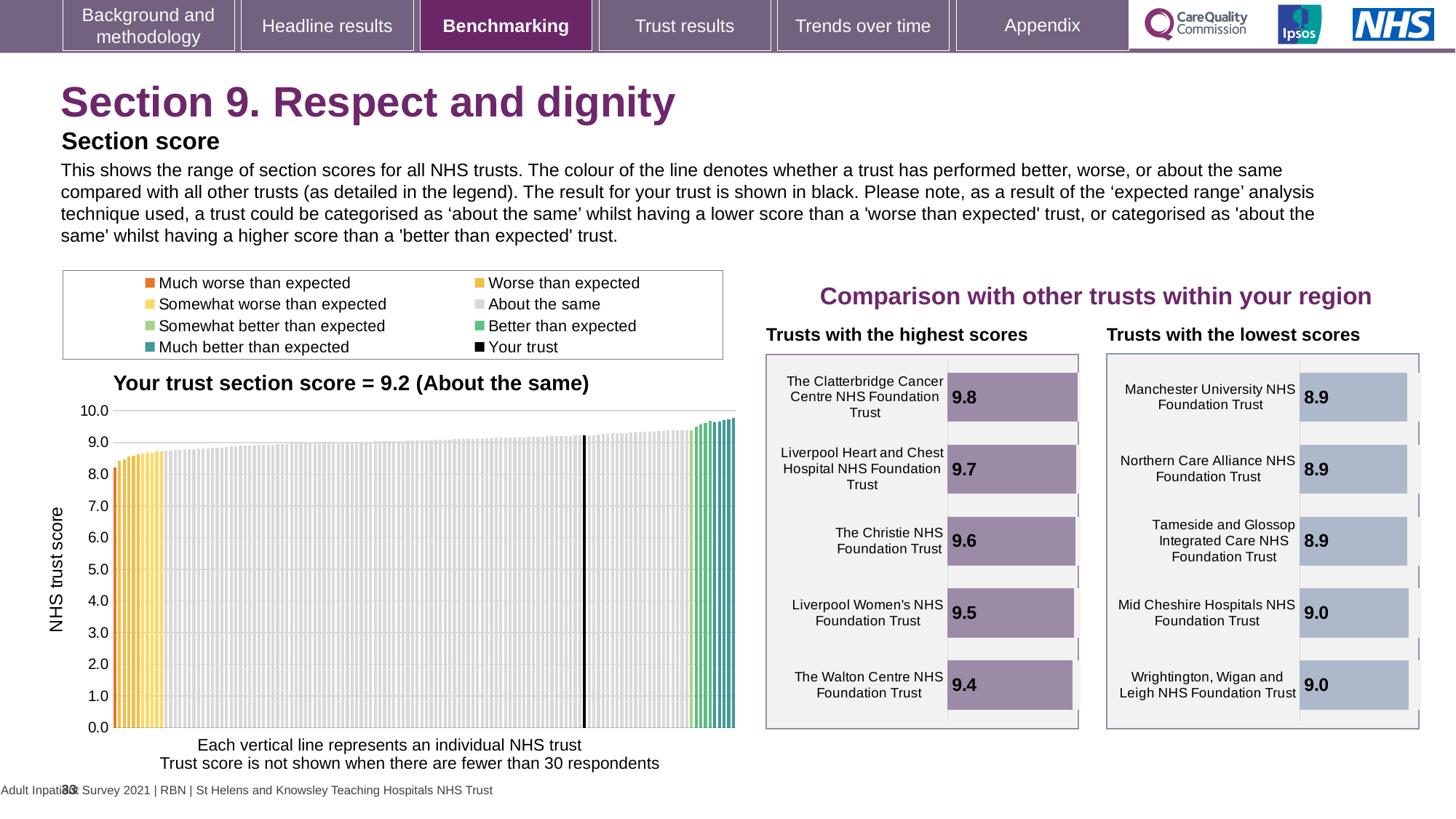
In the main chart on the left, do the trust scores rise or fall from left to right along the x axis? Rise According to the title of the main chart on the left, what is your trust's section score? 9.2 In the 'Trusts with the highest scores' chart, which trust has the highest score? The Clatterbridge Cancer Centre NHS Foundation Trust In the 'Trusts with the highest scores' chart, what is the score for The Walton Centre NHS Foundation Trust? 9.4 How many entries does the legend above the main chart on the left list? 8 How many trusts are listed in the 'Trusts with the lowest scores' chart? 5 What kind of chart is the main chart on the left showing all NHS trusts? Bar chart In the 'Trusts with the lowest scores' chart, what is the score for Mid Cheshire Hospitals NHS Foundation Trust? 9.0 In the 'Trusts with the highest scores' chart, what is the score for The Clatterbridge Cancer Centre NHS Foundation Trust? 9.8 In the 'Trusts with the highest scores' chart, which trust has the lowest score? The Walton Centre NHS Foundation Trust In the 'Trusts with the highest scores' chart, what is the difference between the scores of The Clatterbridge Cancer Centre NHS Foundation Trust and The Walton Centre NHS Foundation Trust? 0.4 In the 'Trusts with the highest scores' chart, which has the larger score: The Christie NHS Foundation Trust or Liverpool Women's NHS Foundation Trust? The Christie NHS Foundation Trust